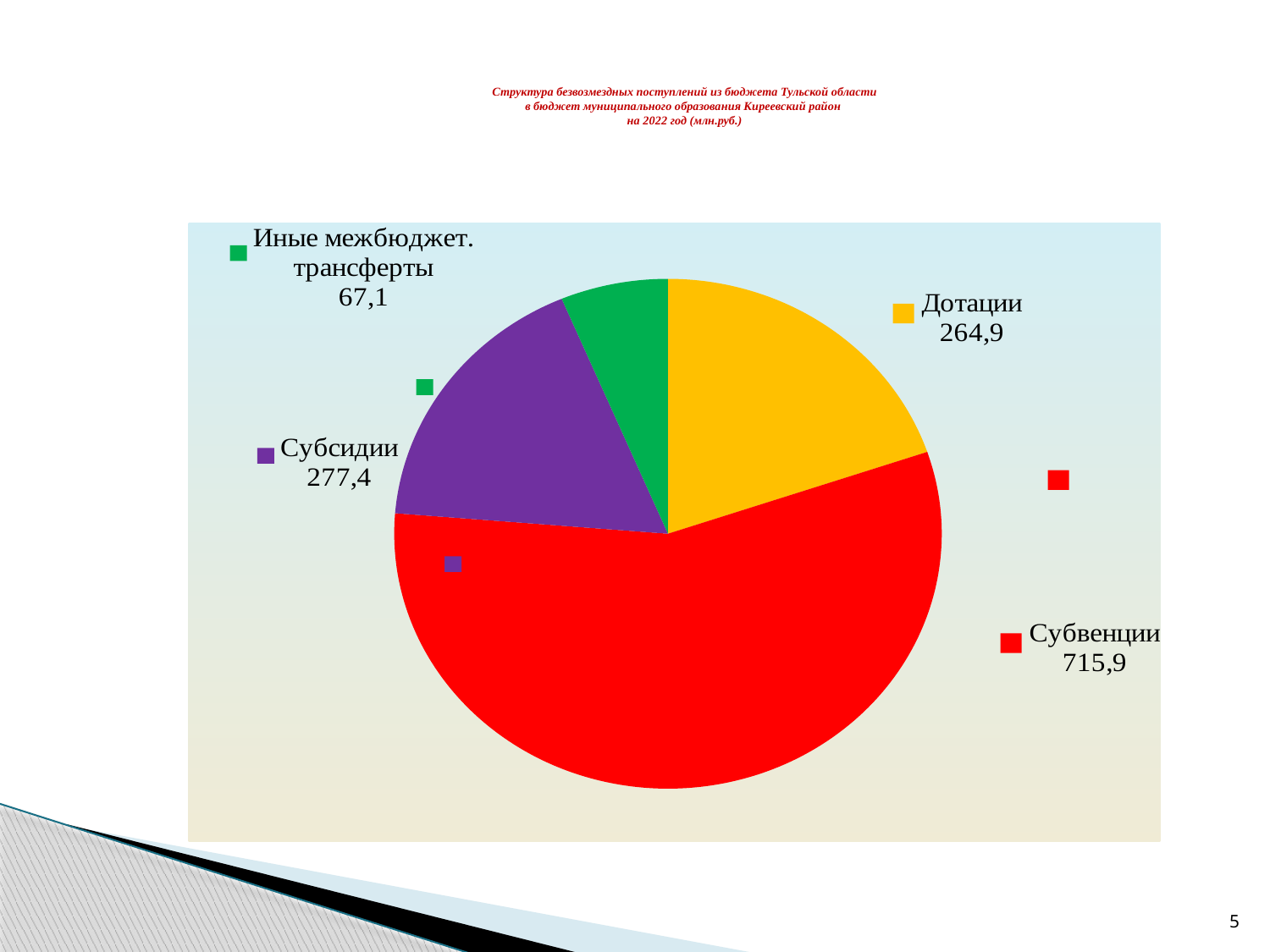
Which category has the largest slice of the pie? Субвенции What is the value for Субвенции? 715,9 What is the difference between the values for Субвенции and Дотации? 451,0 What kind of chart is shown on the slide? pie chart What is the total of all four slices of the pie? 1325,3 What colour is the Субвенции slice? red Which is larger, the value for Субсидии or the value for Дотации? Субсидии What is the value for Субсидии? 277,4 How many slices does the pie chart have? 4 What is the value for Иные межбюджет. трансферты? 67,1 Which category has the smallest slice of the pie? Иные межбюджет. трансферты What is the value for Дотации? 264,9